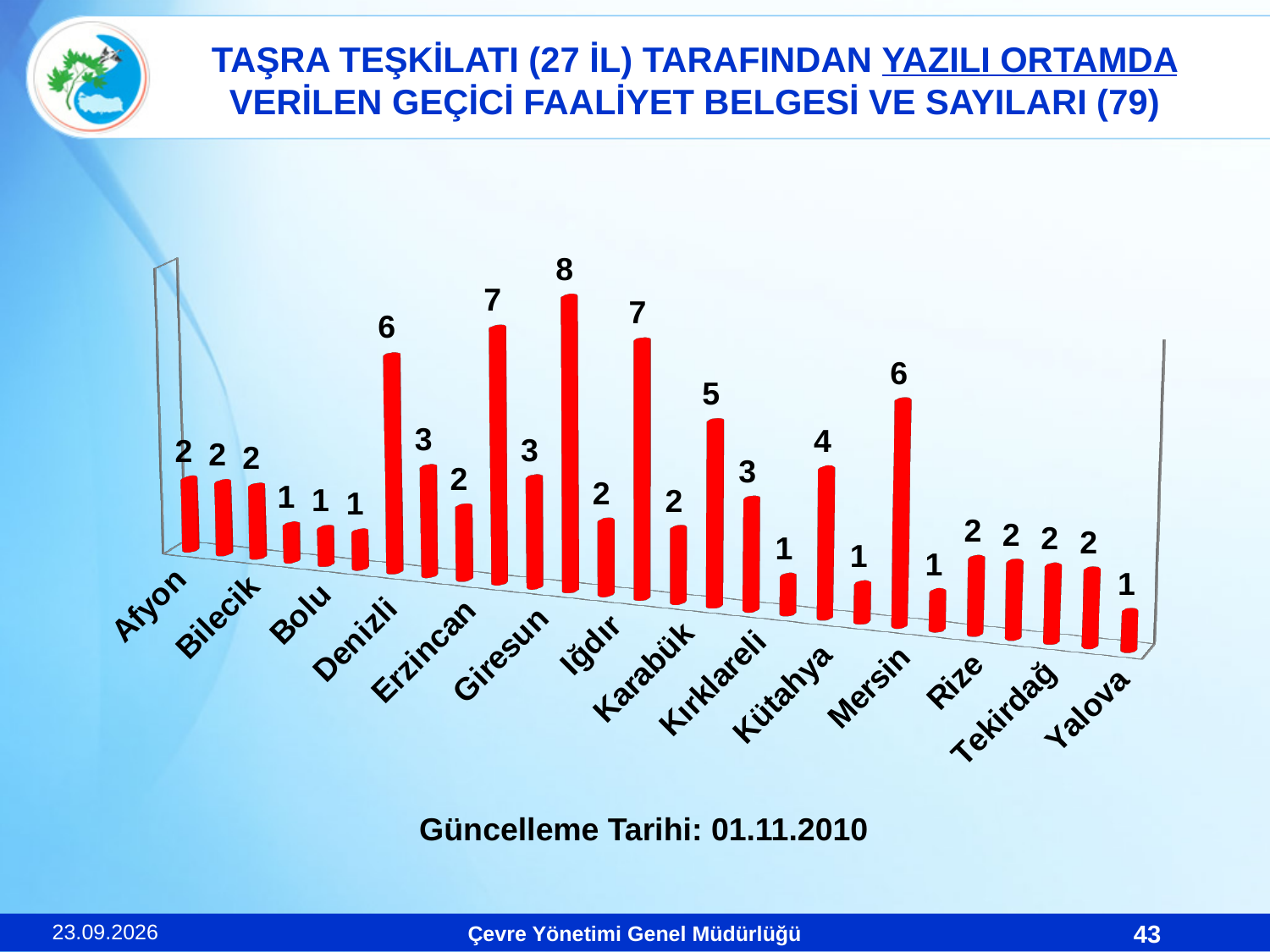
What is the value shown for Kütahya? 4 What is the value shown for Mersin? 6 What is the lowest value labelled on any bar in the chart? 1 What is the difference between the values for Denizli and Kütahya? 2 What is the value shown for Yalova? 1 How many bars are plotted in the chart? 27 What type of chart is shown on the slide? bar chart Which has a larger value, Mersin or Kırklareli? Mersin What is the value shown for Bolu? 1 What is the value shown for Denizli? 6 What colour are the bars in the chart? red What is the highest value labelled on any bar in the chart? 8